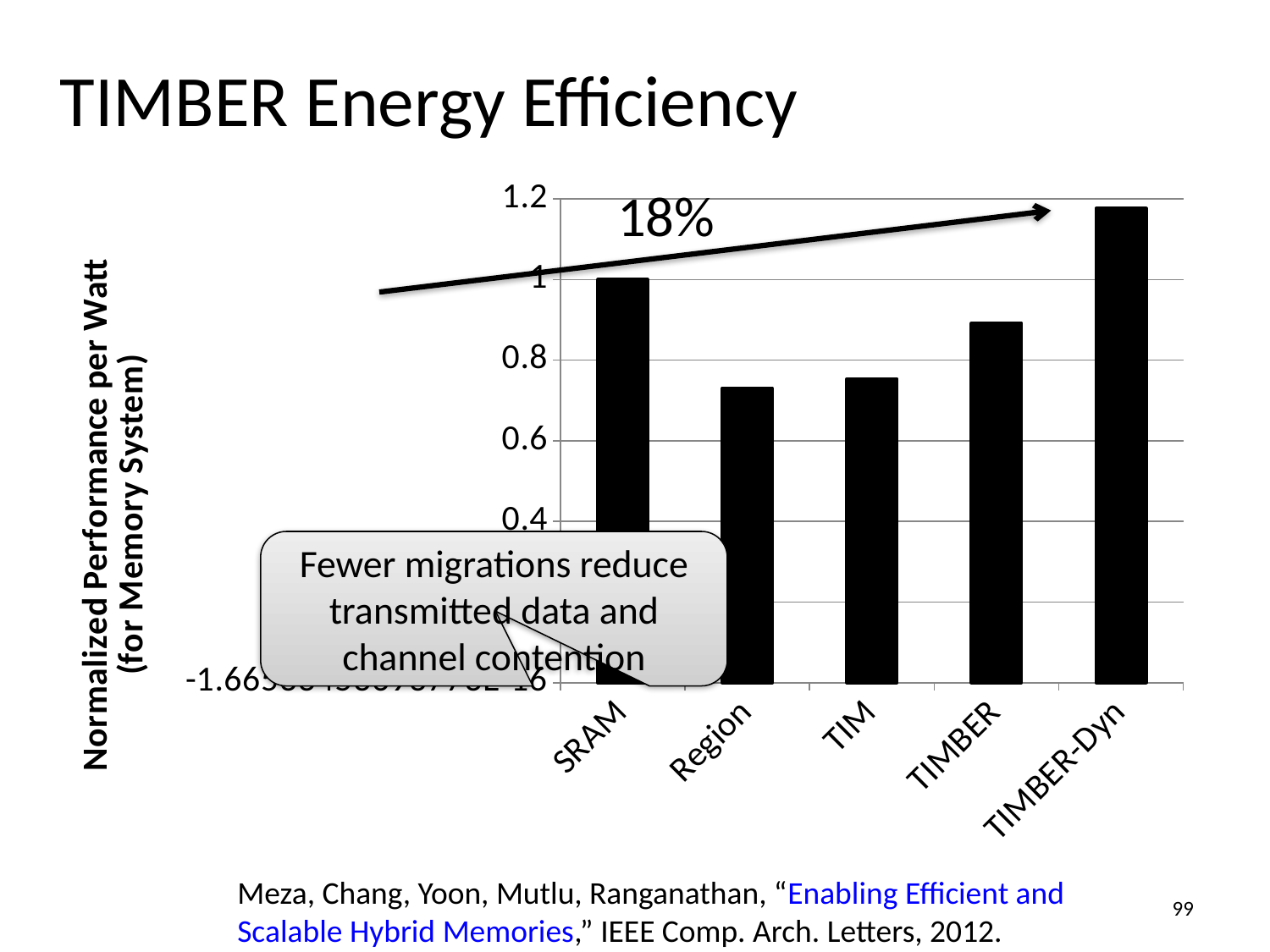
How many categories are plotted on the x axis? 5 Which category has the highest normalized performance per watt? TIMBER-Dyn Is the value for TIMBER greater or less than 1? less What kind of chart is shown on the slide? bar chart Is the value for TIMBER greater or less than 0.8? greater Which has a higher normalized performance per watt, TIMBER or TIM? TIMBER Which has a higher normalized performance per watt, SRAM or Region? SRAM Is the value for TIMBER-Dyn greater or less than 1? greater What percentage improvement is annotated by the arrow on the chart? 18% What is the normalized performance per watt for SRAM? 1